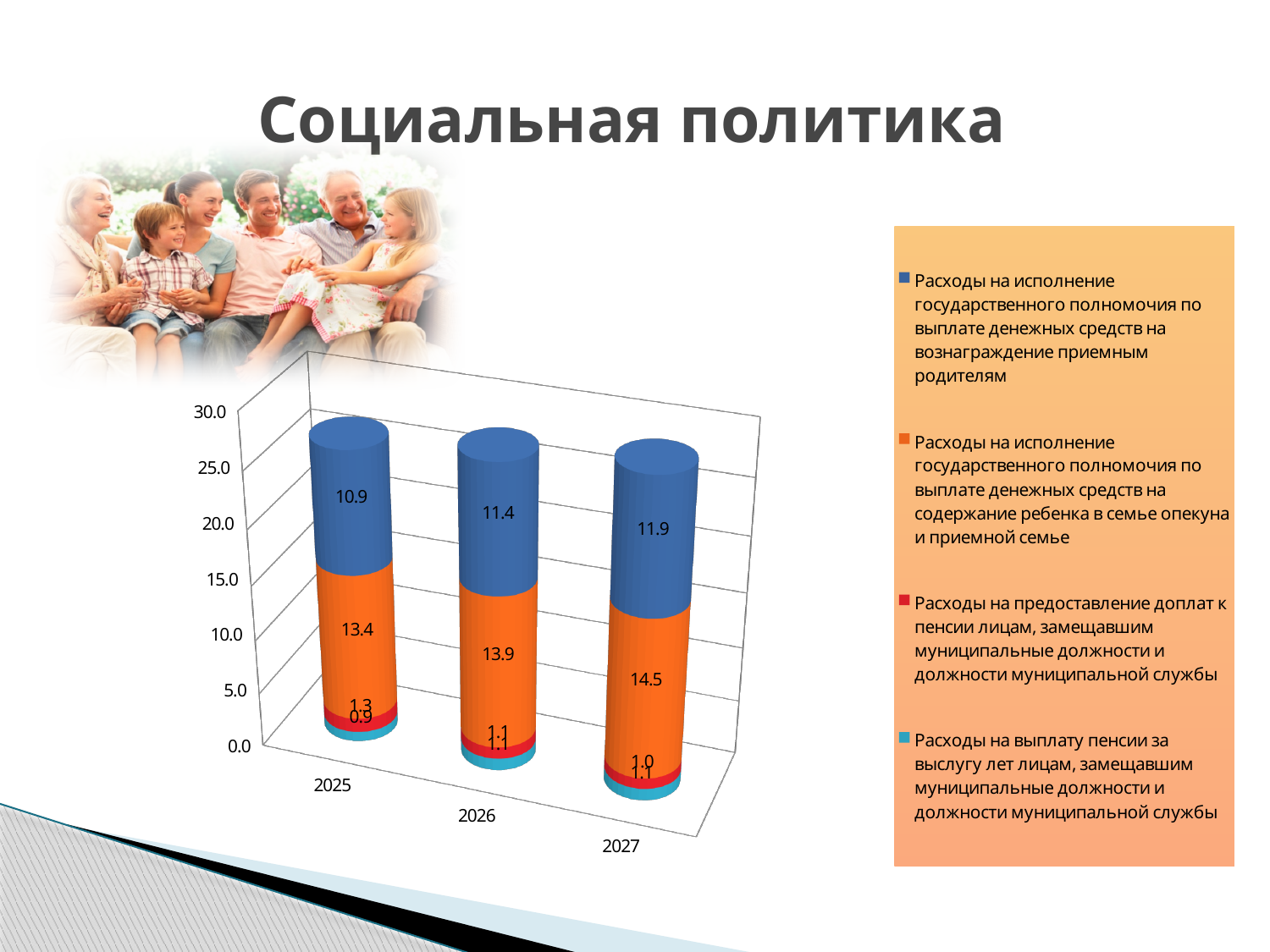
What is the value of the blue series (расходы на вознаграждение приемным родителям) for 2026? 11.4 Does the blue series (расходы на вознаграждение приемным родителям) rise or fall from 2025 to 2027? rise What is the value of the orange series (расходы на содержание ребенка в семье опекуна и приемной семье) for 2027? 14.5 What is the value of the blue series (расходы на вознаграждение приемным родителям) for 2025? 10.9 How many series does the chart legend list? 4 What is the difference between the orange series values for 2027 and 2025? 1.1 How many years (categories) are shown on the x axis of the chart? 3 In which year is the orange series (расходы на содержание ребенка в семье опекуна и приемной семье) highest? 2027 Which is larger: the blue series value for 2027 or the blue series value for 2025? 2027 What is the total of the stacked bar for 2026? 27.5 In which year is the blue series (расходы на вознаграждение приемным родителям) lowest? 2025 What type of chart is shown on the slide? bar chart